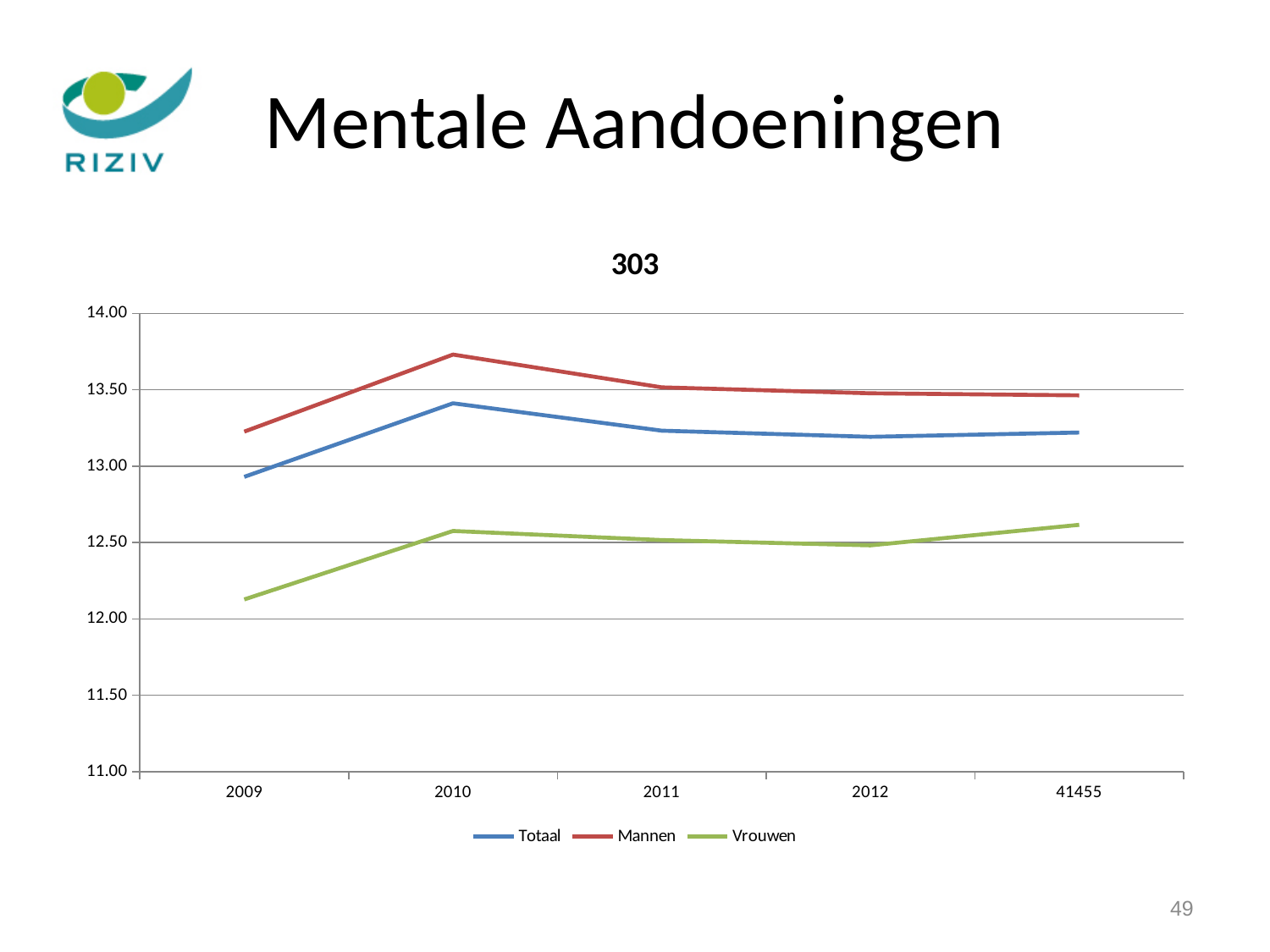
Is the value for Vrouwen in 2009 greater or less than 12.00? greater In which year is the Vrouwen series at its lowest value? 2009 In which year does the Mannen series reach its highest value? 2010 Which series is drawn with the red line? Mannen Which is larger in 2011, the value for Mannen or the value for Vrouwen? Mannen Is the value for Totaal in 2009 greater or less than 13.00? less Is the value for Mannen in 2010 greater or less than 13.50? greater How many series does the legend list? 3 What kind of chart is shown on the slide? line chart Does the Vrouwen series rise or fall from 2009 to 2010? rise How many points are plotted along the x axis for each series? 5 What is the title of the chart? 303